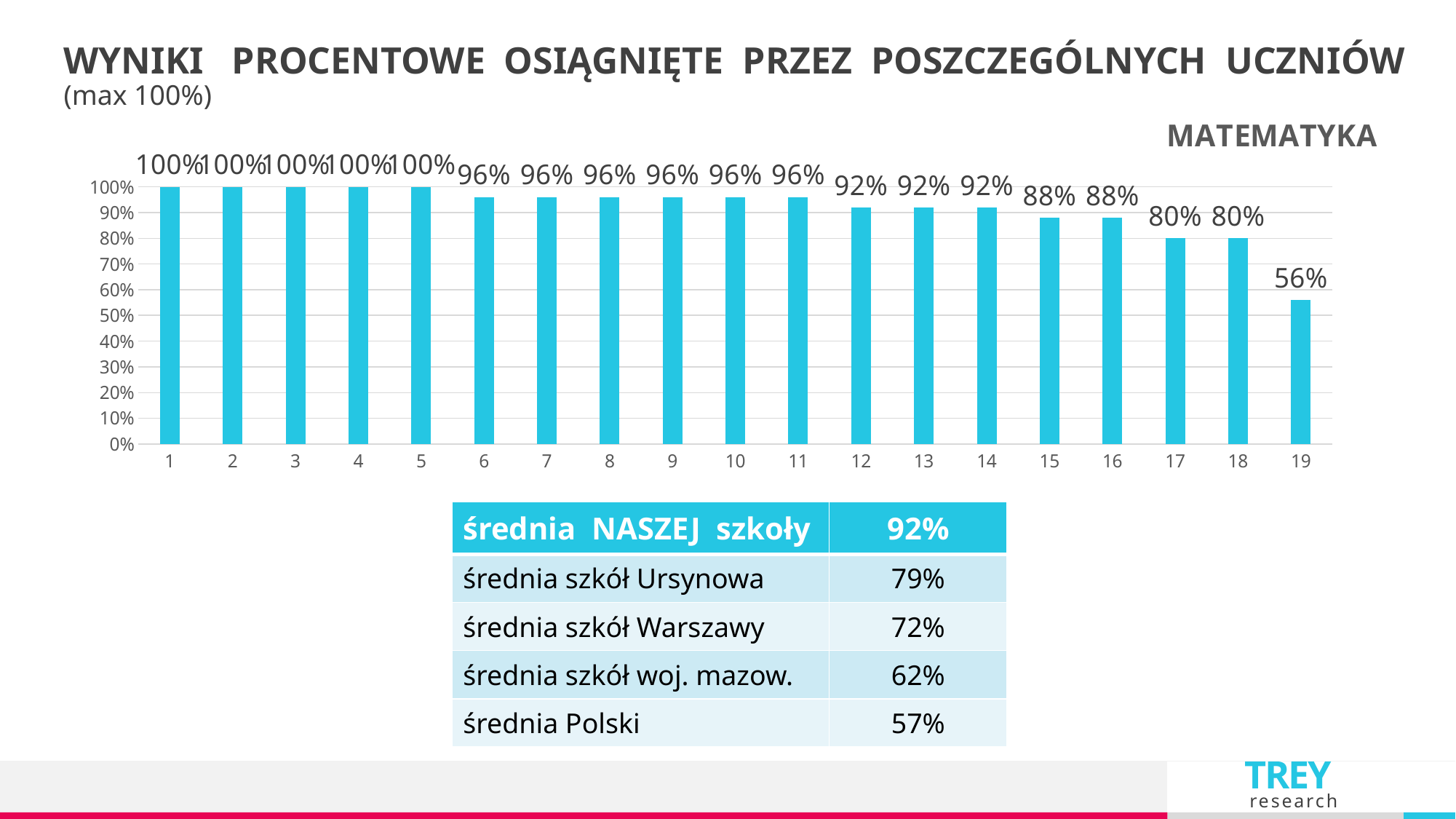
What is the value for student 12? 92% What is the difference between the values for student 1 and student 19? 44% What is the value for student 19? 56% Which subject is named above the chart? MATEMATYKA What is the difference between the values for student 6 and student 15? 8% Do the values rise or fall from student 1 to student 19? fall How many students (bars) are shown in the chart? 19 Is the value for student 19 greater or less than 60%? less Which student has the lowest result? 19 What kind of chart is shown on the slide? bar chart What is the value for student 17? 80% Which is larger, the value for student 14 or the value for student 16? student 14